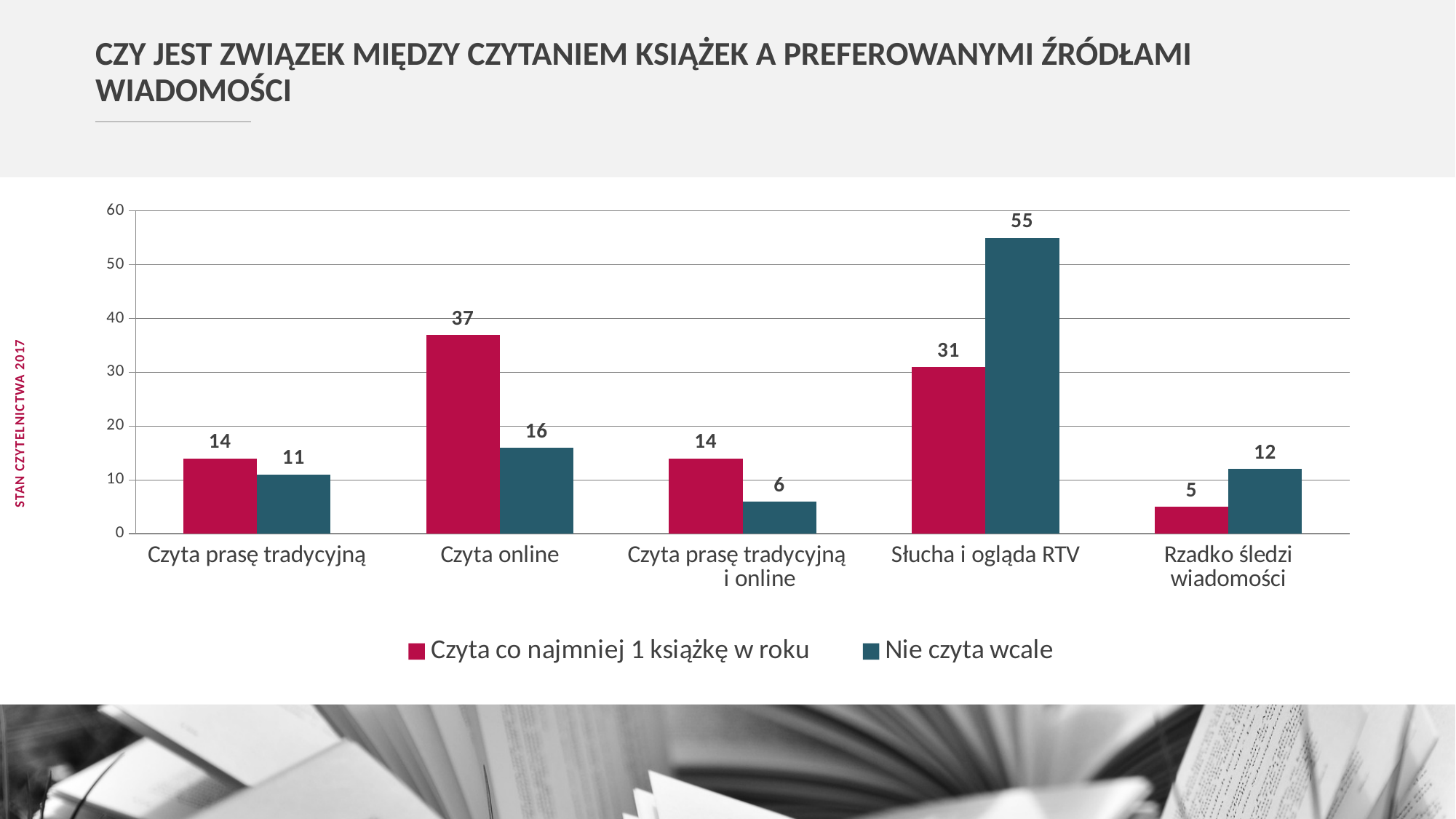
What kind of chart is shown on the slide? bar chart What is the value for "Słucha i ogląda RTV" in the "Nie czyta wcale" series? 55 Which category has the highest value in the "Nie czyta wcale" series? Słucha i ogląda RTV How many categories are shown on the x axis? 5 What is the value for "Rzadko śledzi wiadomości" in the "Czyta co najmniej 1 książkę w roku" series? 5 For "Czyta online", which series has the larger value? Czyta co najmniej 1 książkę w roku What is the value for "Czyta online" in the "Czyta co najmniej 1 książkę w roku" series? 37 What is the difference between the two series for "Słucha i ogląda RTV"? 24 Which category has the lowest value in the "Czyta co najmniej 1 książkę w roku" series? Rzadko śledzi wiadomości What colour are the bars for the "Nie czyta wcale" series? dark teal How many series does the legend list? 2 Is the value for "Słucha i ogląda RTV" in the "Nie czyta wcale" series greater or less than 50? greater